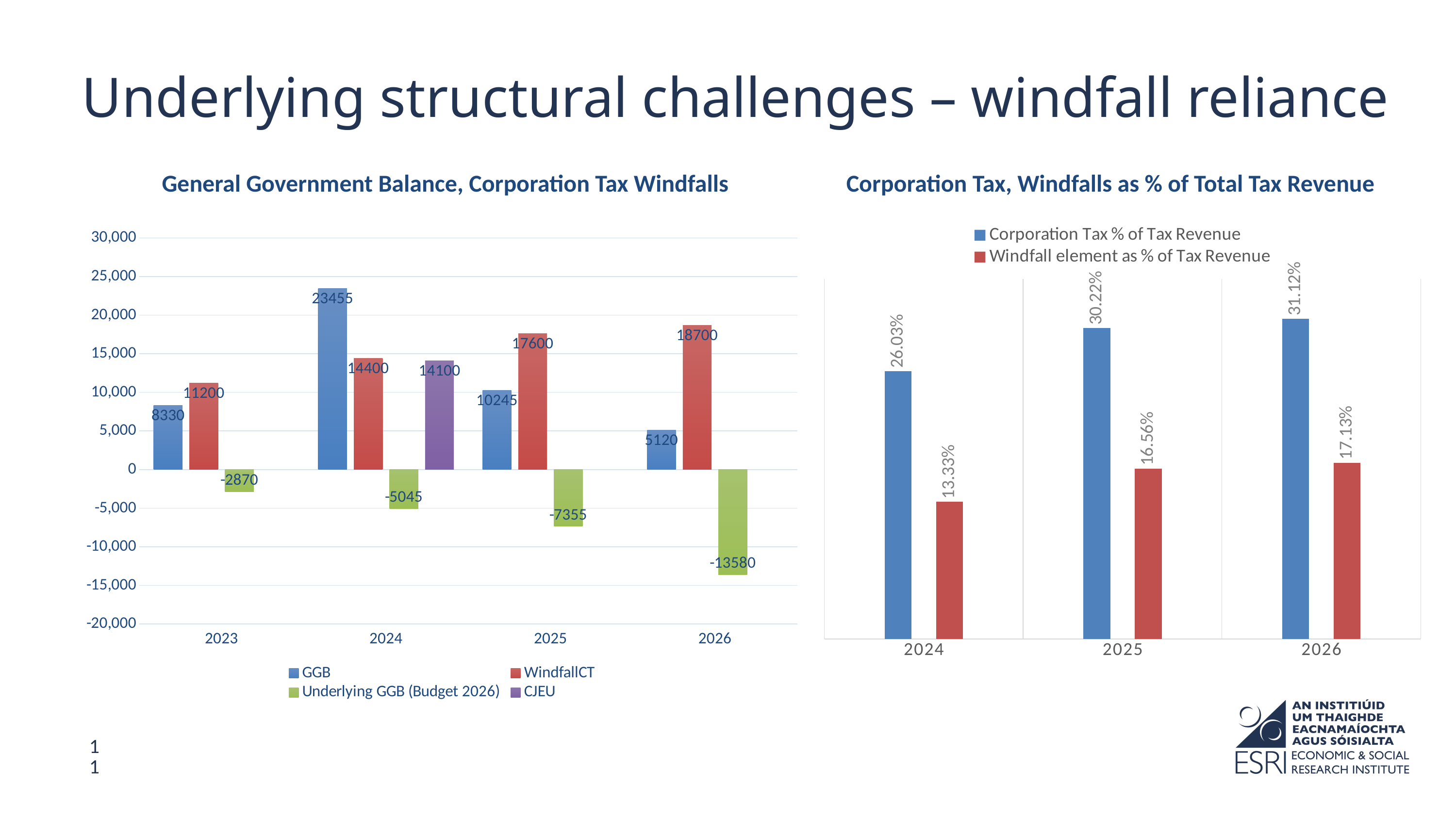
In the 'General Government Balance, Corporation Tax Windfalls' chart, what is the Underlying GGB (Budget 2026) value for 2025? -7355 In the 'General Government Balance, Corporation Tax Windfalls' chart, how many series does the legend list? 4 In the 'General Government Balance, Corporation Tax Windfalls' chart, in which year does the CJEU series appear? 2024 In the 'General Government Balance, Corporation Tax Windfalls' chart, what is the GGB value for 2024? 23455 In the 'Corporation Tax, Windfalls as % of Total Tax Revenue' chart, what is the Corporation Tax % of Tax Revenue for 2025? 30.22% In the 'General Government Balance, Corporation Tax Windfalls' chart, which year has the lowest Underlying GGB (Budget 2026) value? 2026 What kind of chart is the 'Corporation Tax, Windfalls as % of Total Tax Revenue' chart? bar chart In the 'General Government Balance, Corporation Tax Windfalls' chart, what is the difference between the WindfallCT values for 2026 and 2025? 1100 In the 'General Government Balance, Corporation Tax Windfalls' chart, what is the WindfallCT value for 2026? 18700 In the 'Corporation Tax, Windfalls as % of Total Tax Revenue' chart, what is the Windfall element as % of Tax Revenue for 2024? 13.33% In the 'General Government Balance, Corporation Tax Windfalls' chart, which year has the highest GGB value? 2024 In the 'Corporation Tax, Windfalls as % of Total Tax Revenue' chart, does the Corporation Tax % of Tax Revenue rise or fall from 2024 to 2026? rise